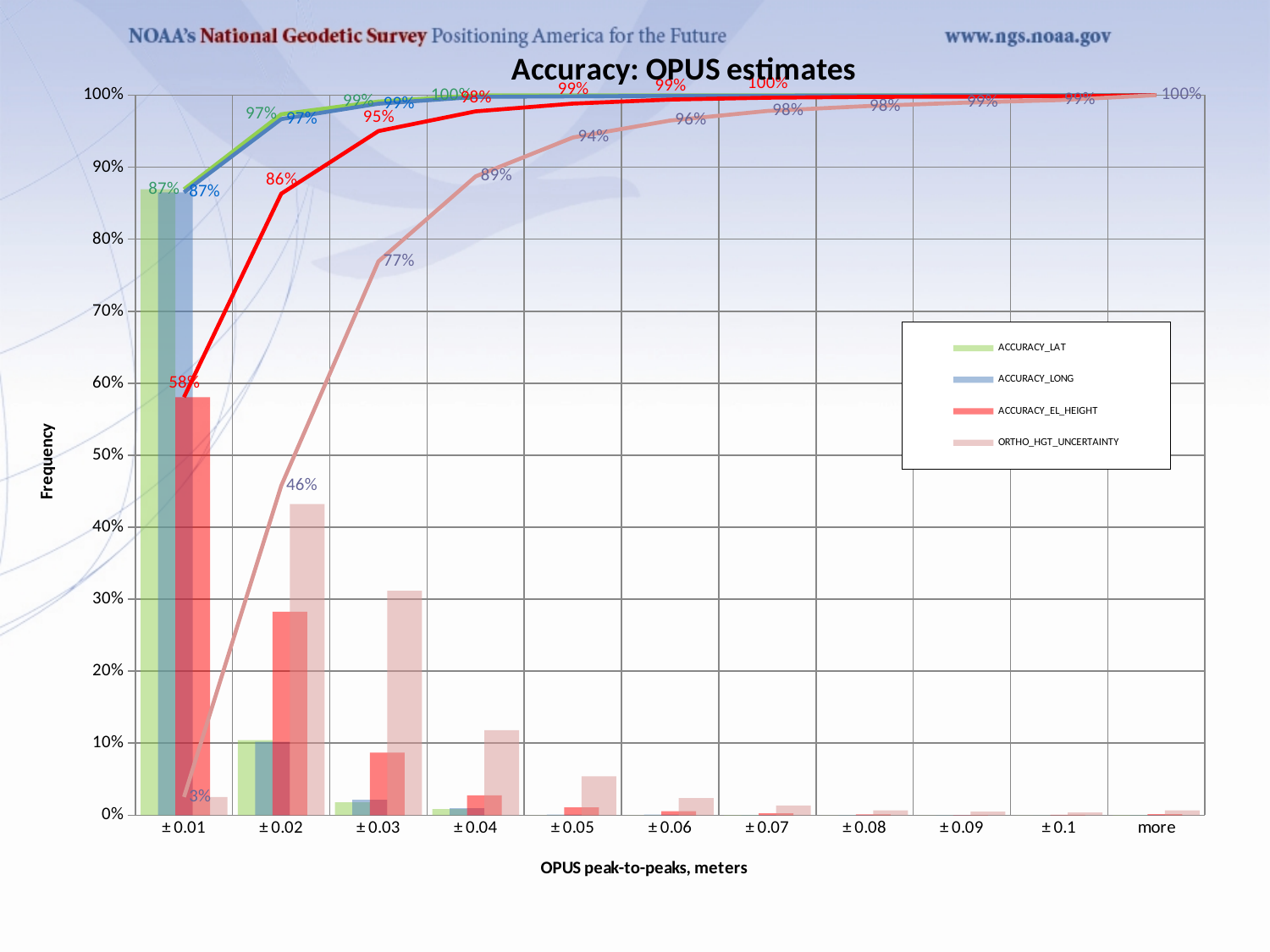
At ± 0.02, which cumulative value is larger: ACCURACY_EL_HEIGHT or ORTHO_HGT_UNCERTAINTY? ACCURACY_EL_HEIGHT What is the cumulative value labelled for ACCURACY_EL_HEIGHT at ± 0.03? 95% What is the cumulative value labelled for ACCURACY_EL_HEIGHT at ± 0.01? 58% Which series has the lowest cumulative value at ± 0.01? ORTHO_HGT_UNCERTAINTY What is the cumulative value labelled for ORTHO_HGT_UNCERTAINTY at ± 0.02? 46% How many series does the legend list? 4 How many categories are shown on the x axis? 11 Is the ACCURACY_EL_HEIGHT bar at ± 0.02 greater or less than 20%? greater Do the cumulative lines rise or fall as the x axis moves from ± 0.01 toward 'more'? rise What is the difference between the cumulative values of ACCURACY_LAT (87%) and ACCURACY_EL_HEIGHT (58%) at ± 0.01? 29 percentage points What is the cumulative value labelled for ORTHO_HGT_UNCERTAINTY at ± 0.03? 77% Is the ORTHO_HGT_UNCERTAINTY bar at ± 0.02 greater or less than 50%? less